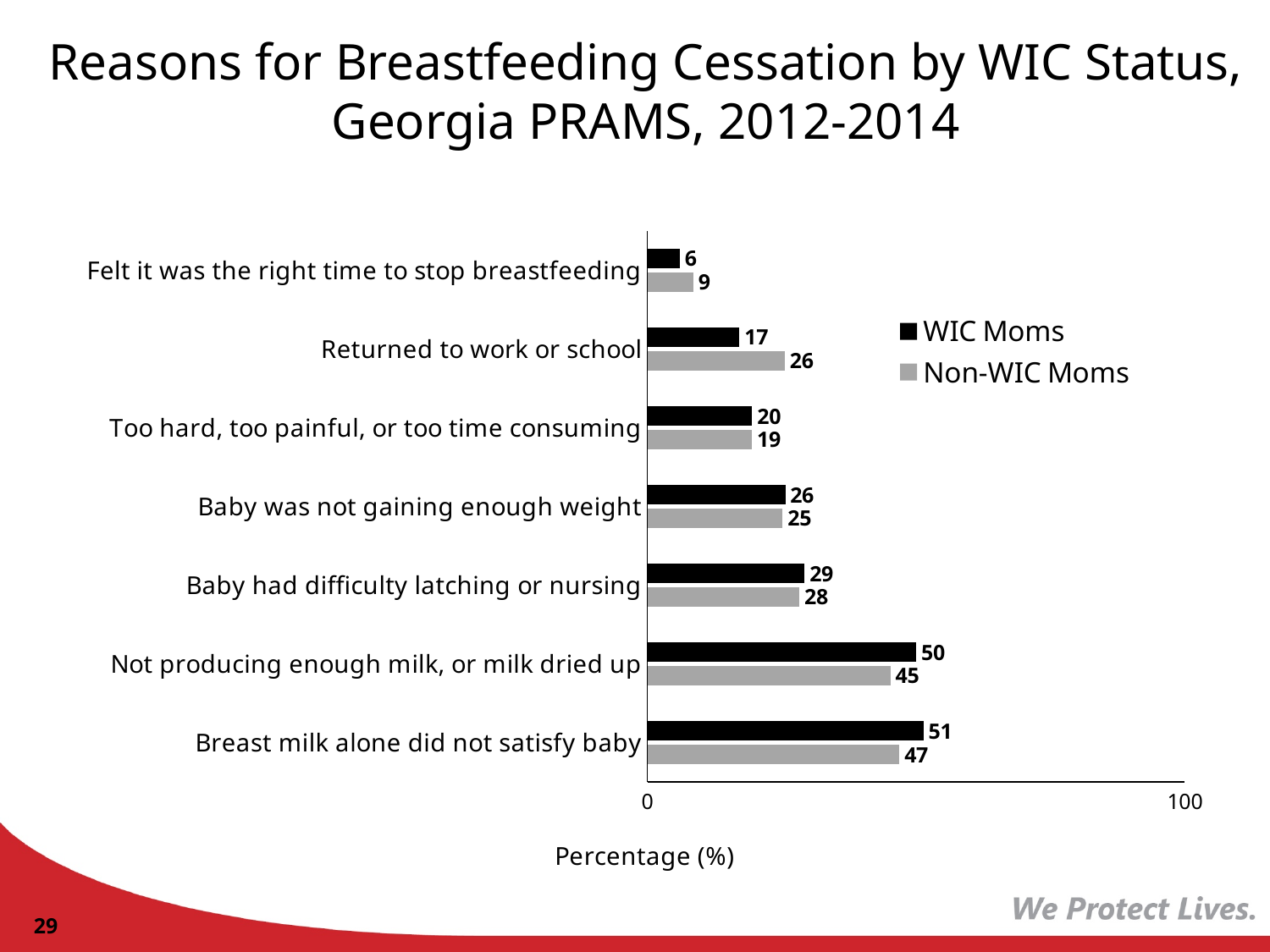
What is the value for Non-WIC Moms for "Not producing enough milk, or milk dried up"? 45 What is the difference between Non-WIC Moms and WIC Moms for "Returned to work or school"? 9 How many reasons (categories) are shown on the chart? 7 What is the value for WIC Moms for "Returned to work or school"? 17 Which reason has the lowest value for Non-WIC Moms? Felt it was the right time to stop breastfeeding What kind of chart is shown on the slide? Bar chart How many series does the legend list? 2 Which colour represents Non-WIC Moms in the legend? Gray What is the label of the x axis? Percentage (%) Which reason has the highest value for WIC Moms? Breast milk alone did not satisfy baby For "Not producing enough milk, or milk dried up", which group has the larger value, WIC Moms or Non-WIC Moms? WIC Moms What is the value for Non-WIC Moms for "Felt it was the right time to stop breastfeeding"? 9